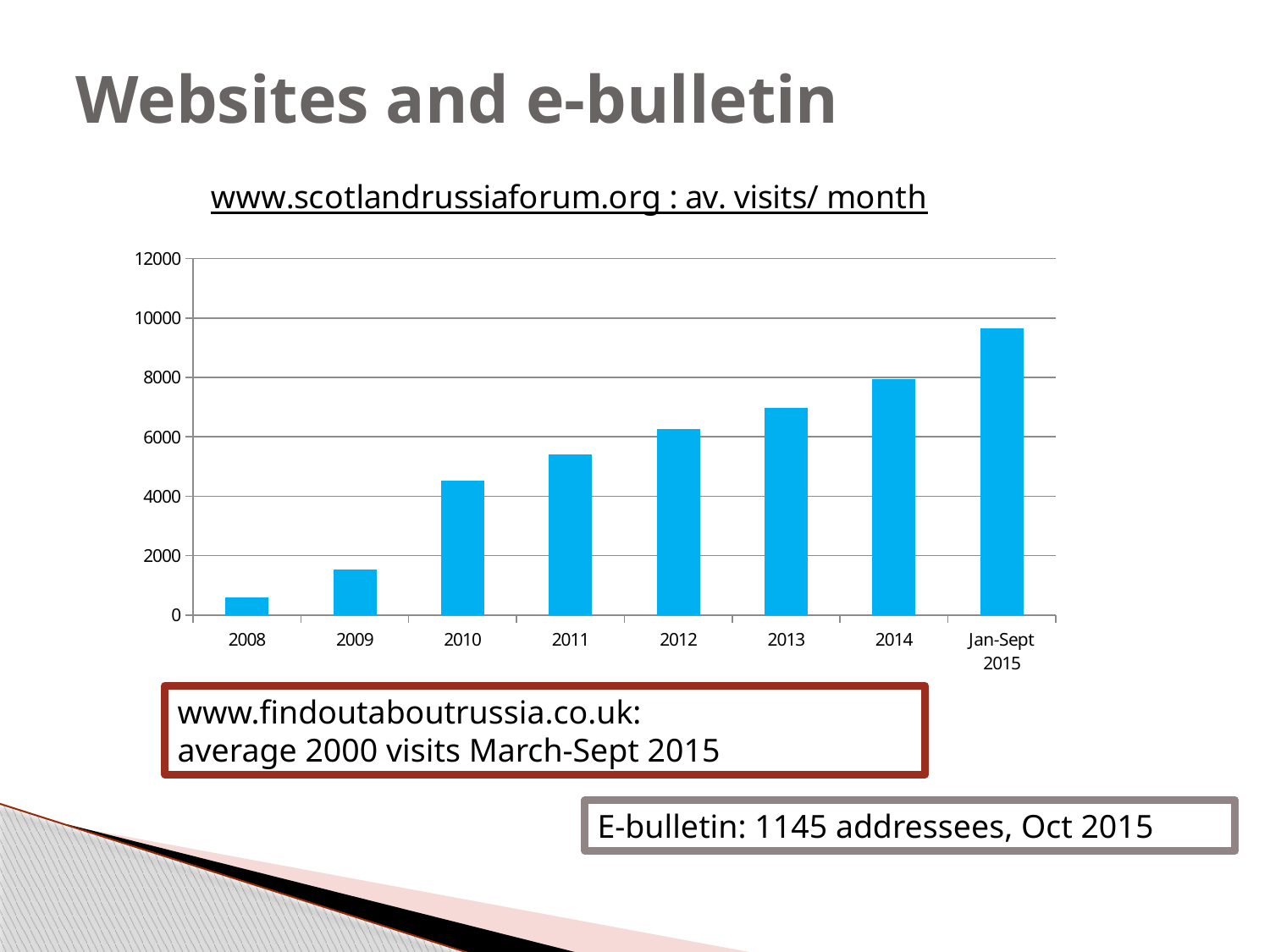
Which is larger, the value for 2009 or the value for 2012? 2012 Do the values rise or fall from 2008 to Jan-Sept 2015? rise Which is larger, the value for 2011 or the value for 2014? 2014 What is the title of the chart? www.scotlandrussiaforum.org : av. visits/ month Is the value for 2010 greater or less than 4000? greater Is the value for 2008 greater or less than 2000? less How many categories are shown on the x axis of the chart? 8 Is the value for 2013 greater or less than 6000? greater Which category has the lowest average visits per month? 2008 Which category has the highest average visits per month? Jan-Sept 2015 What kind of chart is shown on the slide? bar chart